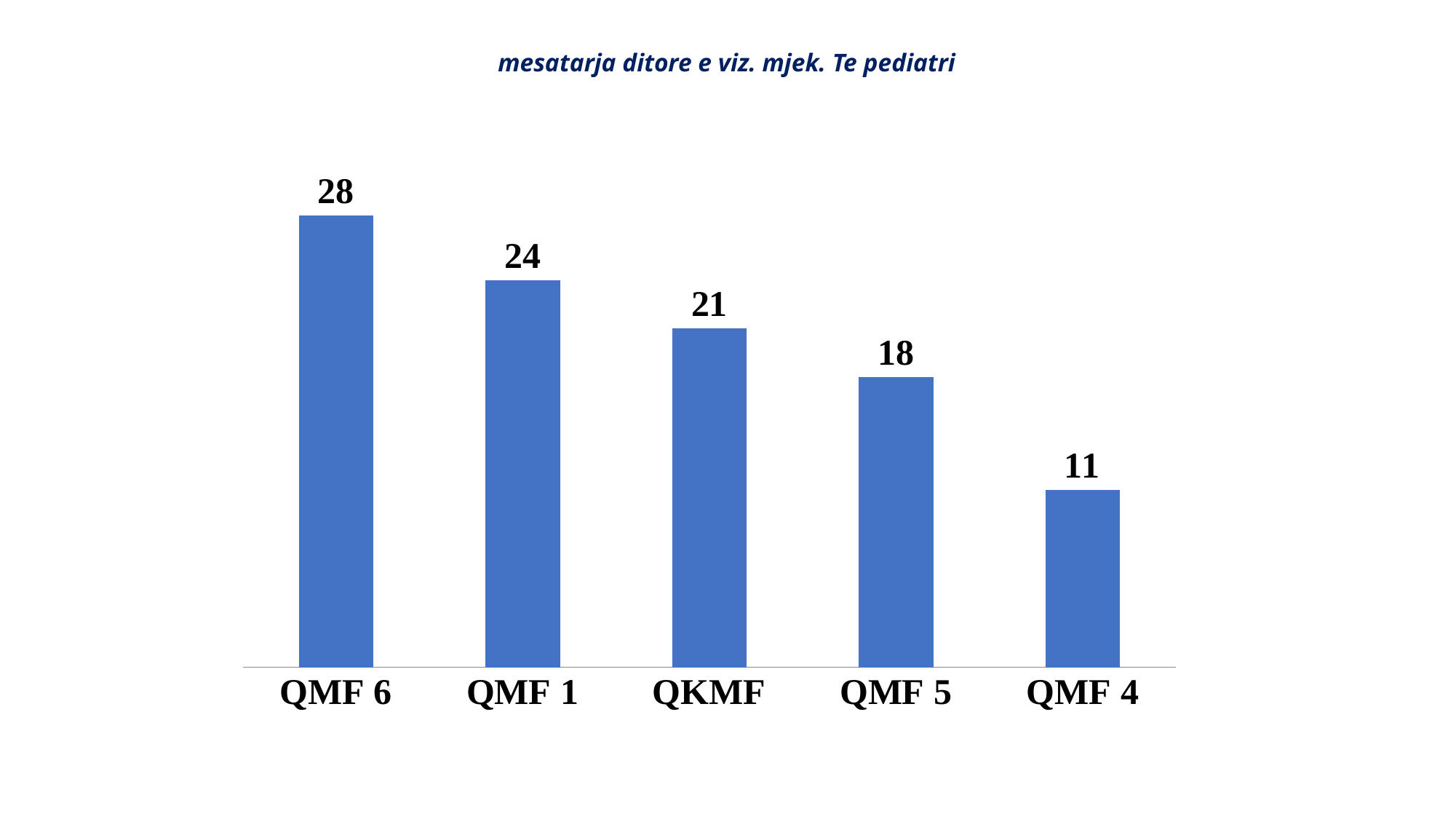
Which category has the highest value? QMF 6 What is the value for QKMF? 21 What is the value for QMF 5? 18 What is the difference between the values for QMF 1 and QMF 5? 6 What is the value for QMF 4? 11 Which category has the lowest value? QMF 4 Which is larger, the value for QMF 1 or the value for QKMF? QMF 1 How many categories are shown in the chart? 5 Do the values rise or fall from left to right along the x axis? Fall What is the value for QMF 6? 28 What kind of chart is shown on the slide? Bar chart What is the difference between the values for QMF 6 and QMF 4? 17